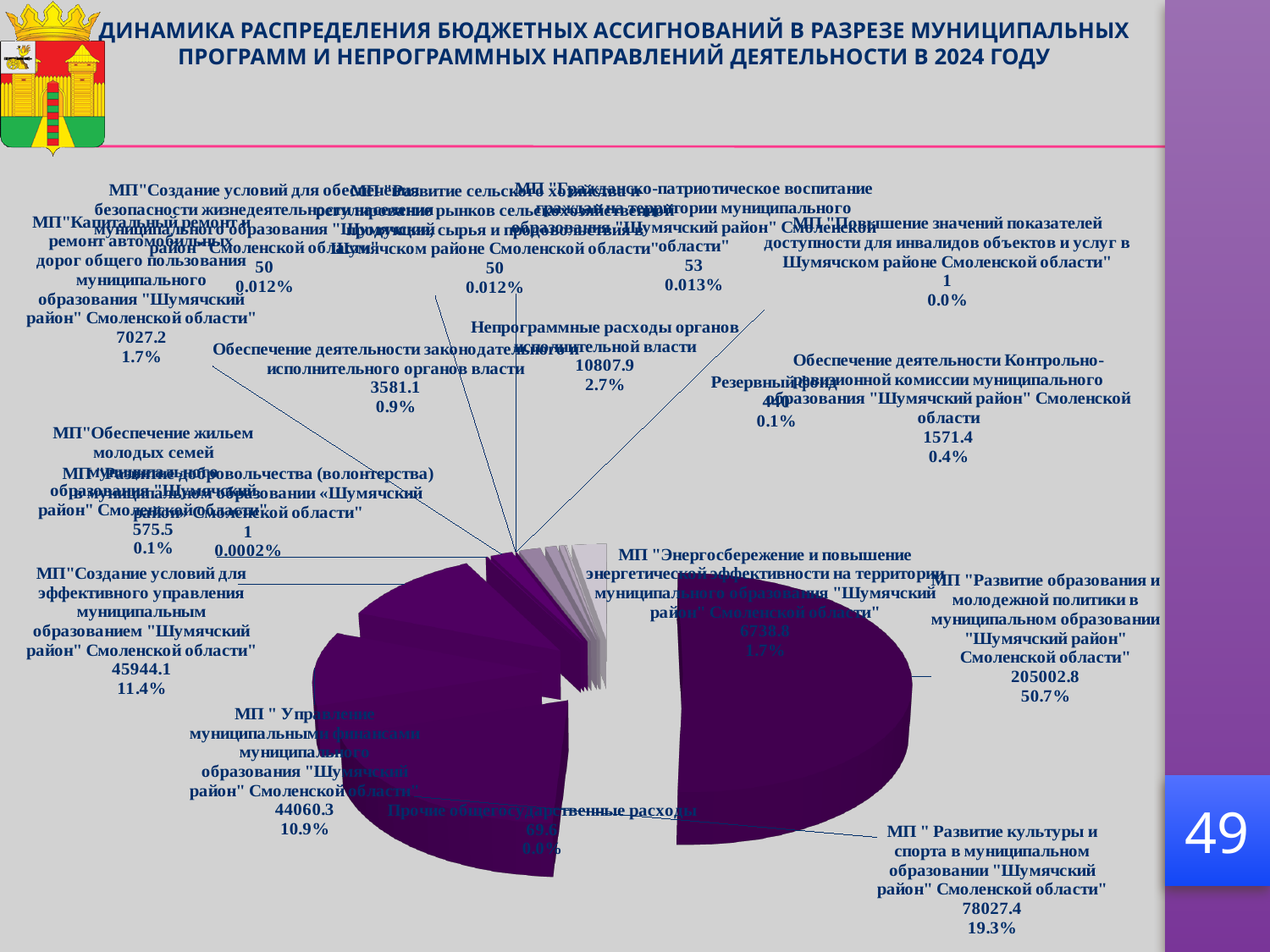
What is the difference between the value for МП "Развитие культуры и спорта" (78027.4) and the value for МП "Создание условий для эффективного управления муниципальным образованием" (45944.1)? 32083.3 What is the value shown for Непрограммные расходы органов исполнительной власти? 10807.9 What is the value shown for Резервный фонд? 440 What share of the pie does МП "Развитие образования и молодежной политики" account for? 50.7% What percentage is shown for Обеспечение деятельности Контрольно-ревизионной комиссии? 0.4% Which category has the largest share of the pie? МП "Развитие образования и молодежной политики в муниципальном образовании "Шумячский район" Смоленской области" Which is larger: the value for МП "Развитие культуры и спорта" or the value for МП "Управление муниципальными финансами"? МП "Развитие культуры и спорта" What is the value shown for МП "Создание условий для эффективного управления муниципальным образованием"? 45944.1 What percentage is shown for МП "Развитие культуры и спорта"? 19.3% What kind of chart is shown on the slide? pie chart What is the value shown for МП "Развитие культуры и спорта в муниципальном образовании "Шумячский район" Смоленской области"? 78027.4 What is the value shown for МП "Управление муниципальными финансами"? 44060.3